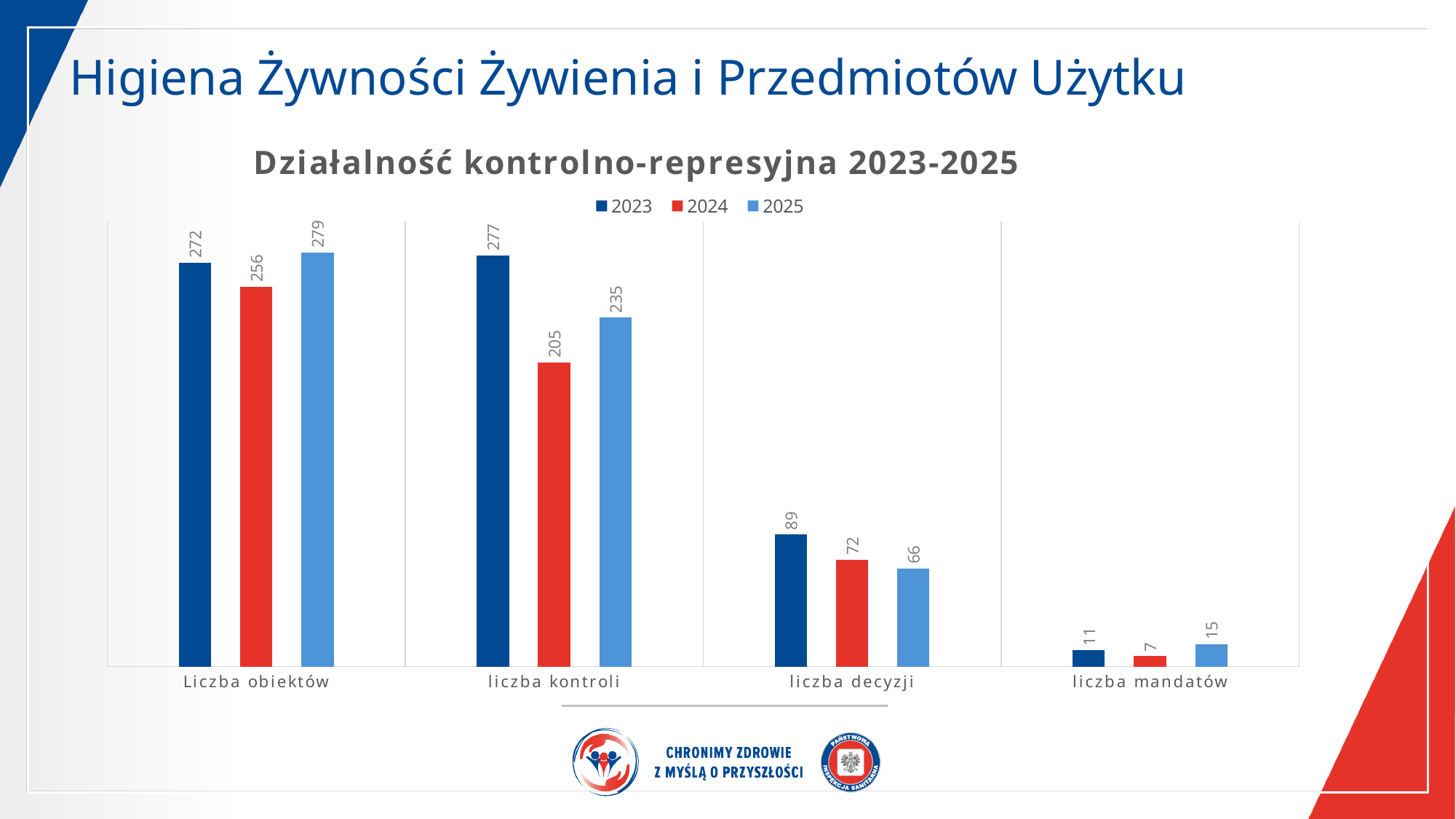
Which year has the highest value in the 'Liczba obiektów' category? 2025 What is the title of the chart? Działalność kontrolno-represyjna 2023-2025 How many series does the legend list? 3 What is the value for 2025 in the 'liczba decyzji' category? 66 What kind of chart is shown on the slide? Bar chart What is the value for 2023 in the 'Liczba obiektów' category? 272 What is the value for 2024 in the 'liczba mandatów' category? 7 What is the value for 2024 in the 'liczba kontroli' category? 205 Which is larger: the 2023 value for 'liczba decyzji' or the 2024 value for 'liczba decyzji'? 2023 What is the difference between the 2023 and 2025 values for 'liczba kontroli'? 42 How many categories are shown on the x axis? 4 Which year has the lowest value in the 'liczba kontroli' category? 2024